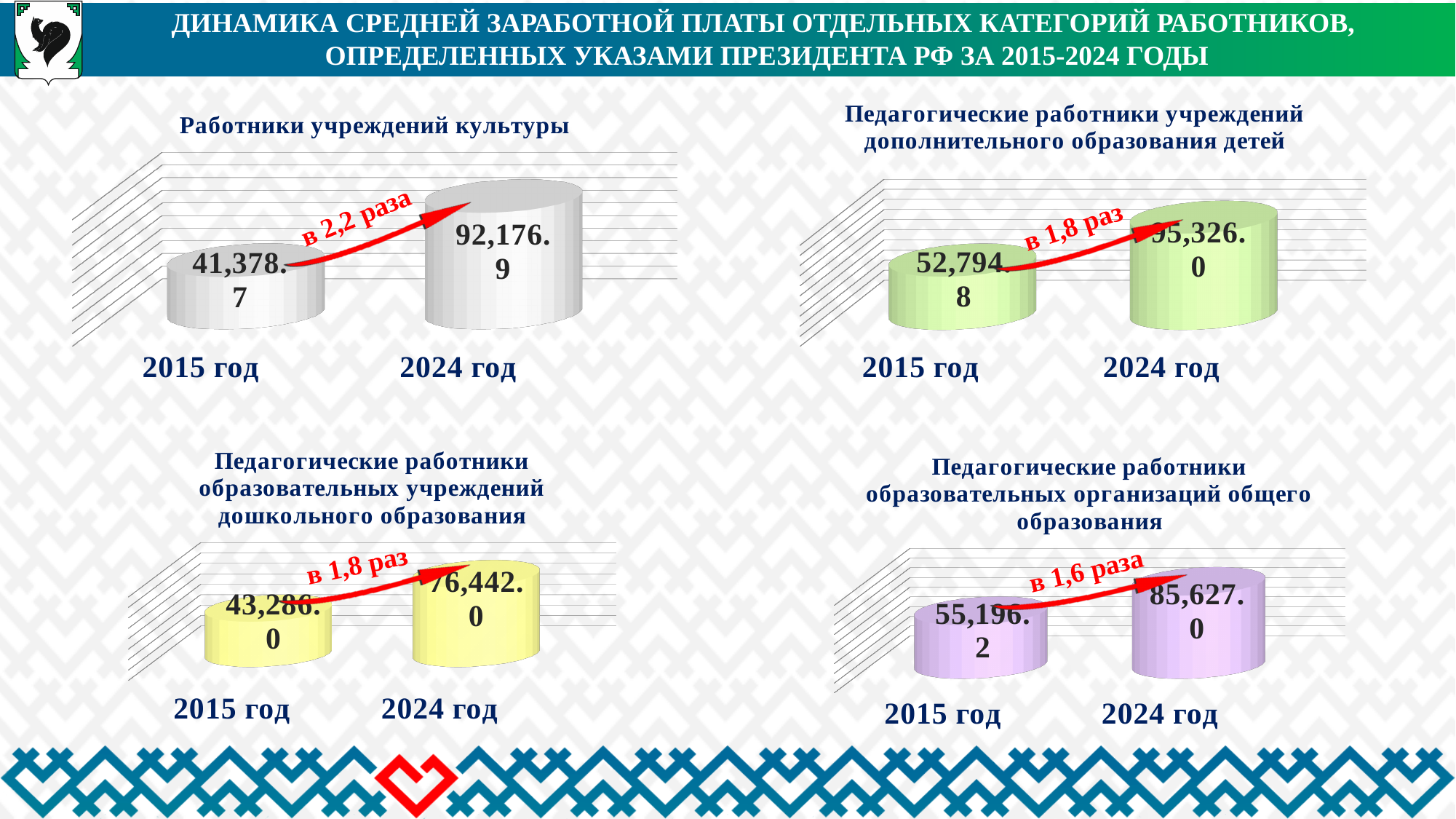
What growth factor is written on the arrow in the chart 'Работники учреждений культуры'? в 2,2 раза In the chart 'Работники учреждений культуры', what is the value for 2015 год? 41,378.7 In the chart 'Работники учреждений культуры', what is the value for 2024 год? 92,176.9 In the chart 'Педагогические работники образовательных организаций общего образования', do the values rise or fall from 2015 год to 2024 год? Rise In the chart 'Педагогические работники учреждений дополнительного образования детей', which year has the higher value, 2015 год or 2024 год? 2024 год In the chart 'Работники учреждений культуры', what is the difference between the 2024 год and 2015 год values? 50,798.2 In the chart 'Педагогические работники образовательных организаций общего образования', which year has the lowest value? 2015 год What kind of chart is used for 'Работники учреждений культуры'? Bar chart How many categories are shown in the chart 'Педагогические работники образовательных учреждений дошкольного образования'? 2 In the chart 'Педагогические работники образовательных организаций общего образования', what is the value for 2024 год? 85,627.0 In the chart 'Педагогические работники образовательных учреждений дошкольного образования', what is the value for 2024 год? 76,442.0 How many charts are shown on the slide? 4